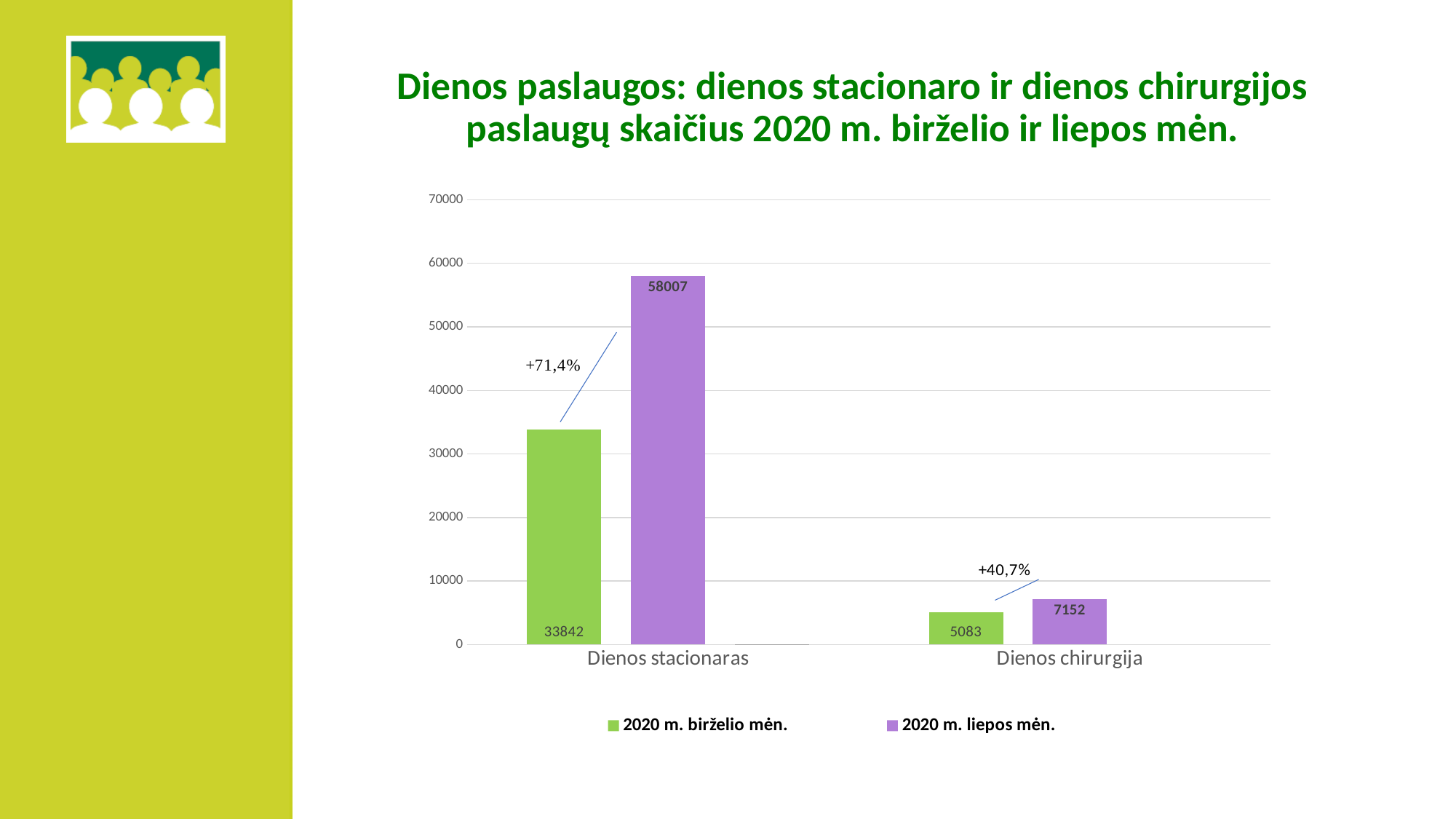
What is the value for Dienos stacionaras in 2020 m. birželio mėn.? 33842 How many series does the legend list? 2 What is the value for Dienos stacionaras in 2020 m. liepos mėn.? 58007 Which bar has the highest value on the chart? Dienos stacionaras, 2020 m. liepos mėn. What is the value for Dienos chirurgija in 2020 m. birželio mėn.? 5083 What is the value for Dienos chirurgija in 2020 m. liepos mėn.? 7152 What is the difference between the 2020 m. liepos mėn. and 2020 m. birželio mėn. values for Dienos chirurgija? 2069 Which is larger for Dienos chirurgija: the 2020 m. birželio mėn. value or the 2020 m. liepos mėn. value? 2020 m. liepos mėn. Which bar has the lowest value on the chart? Dienos chirurgija, 2020 m. birželio mėn. What percentage change is annotated for Dienos stacionaras? +71,4% How many categories are shown on the x axis? 2 What is the difference between the 2020 m. liepos mėn. and 2020 m. birželio mėn. values for Dienos stacionaras? 24165